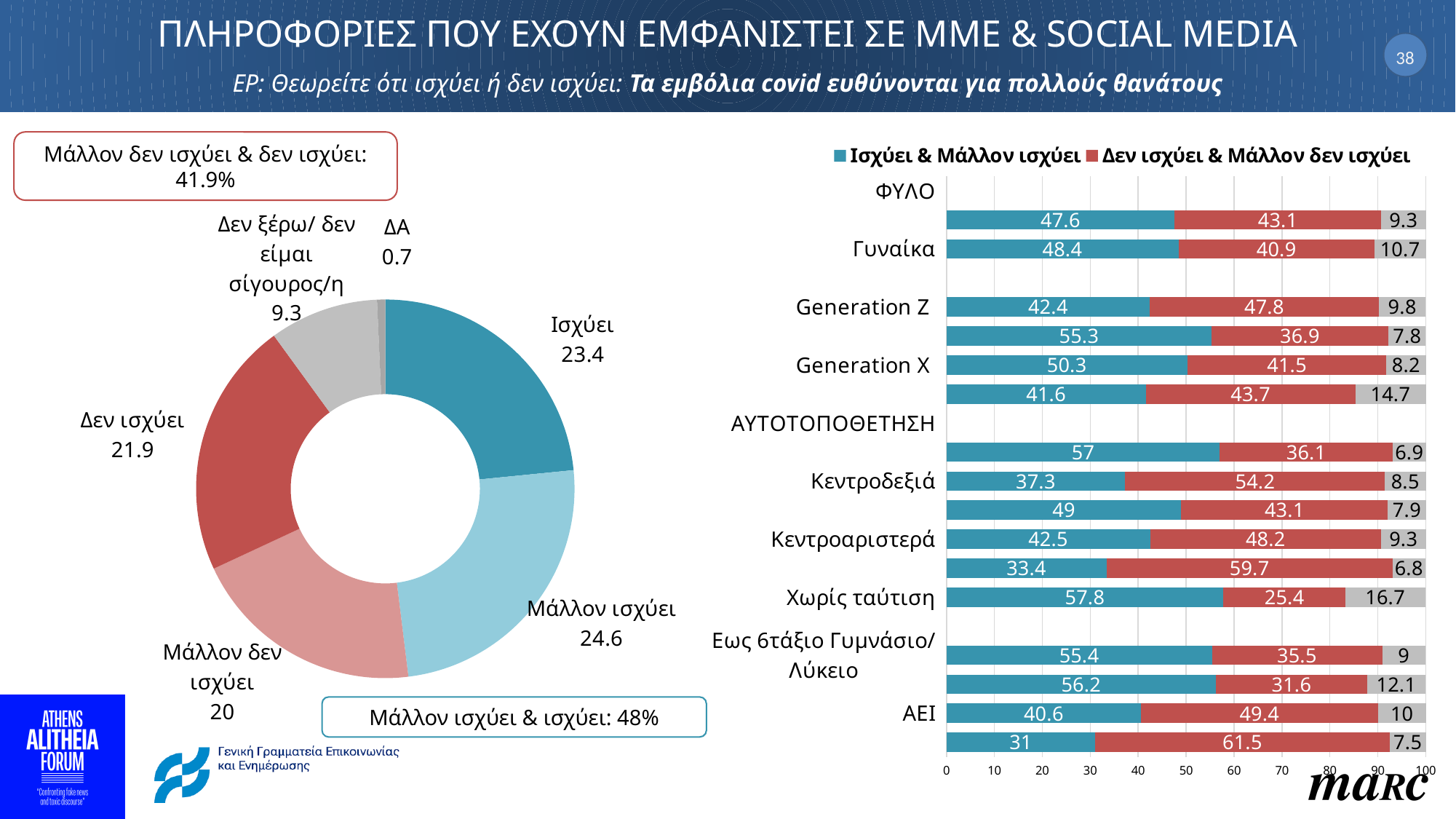
In the bar chart on the right, which is larger for Generation Z: Ισχύει & Μάλλον ισχύει or Δεν ισχύει & Μάλλον δεν ισχύει? Δεν ισχύει & Μάλλον δεν ισχύει In the donut chart on the left, what is the value for Δεν ισχύει? 21.9 In the donut chart on the left, which category has the largest value? Μάλλον ισχύει What kind of chart is shown on the right side of the slide? Stacked bar chart In the bar chart on the right, what is the value of Ισχύει & Μάλλον ισχύει for Γυναίκα? 48.4 In the bar chart on the right, what is the value of Ισχύει & Μάλλον ισχύει for Χωρίς ταύτιση? 57.8 In the donut chart on the left, which category has the smallest value? ΔΑ In the bar chart on the right, what is the value of Δεν ισχύει & Μάλλον δεν ισχύει for Κεντροδεξιά? 54.2 In the donut chart on the left, what is the value for Ισχύει? 23.4 In the bar chart on the right, how many series does the legend list? 2 In the donut chart on the left, how many categories are shown? 6 In the donut chart on the left, what is the difference between Μάλλον ισχύει and Μάλλον δεν ισχύει? 4.6